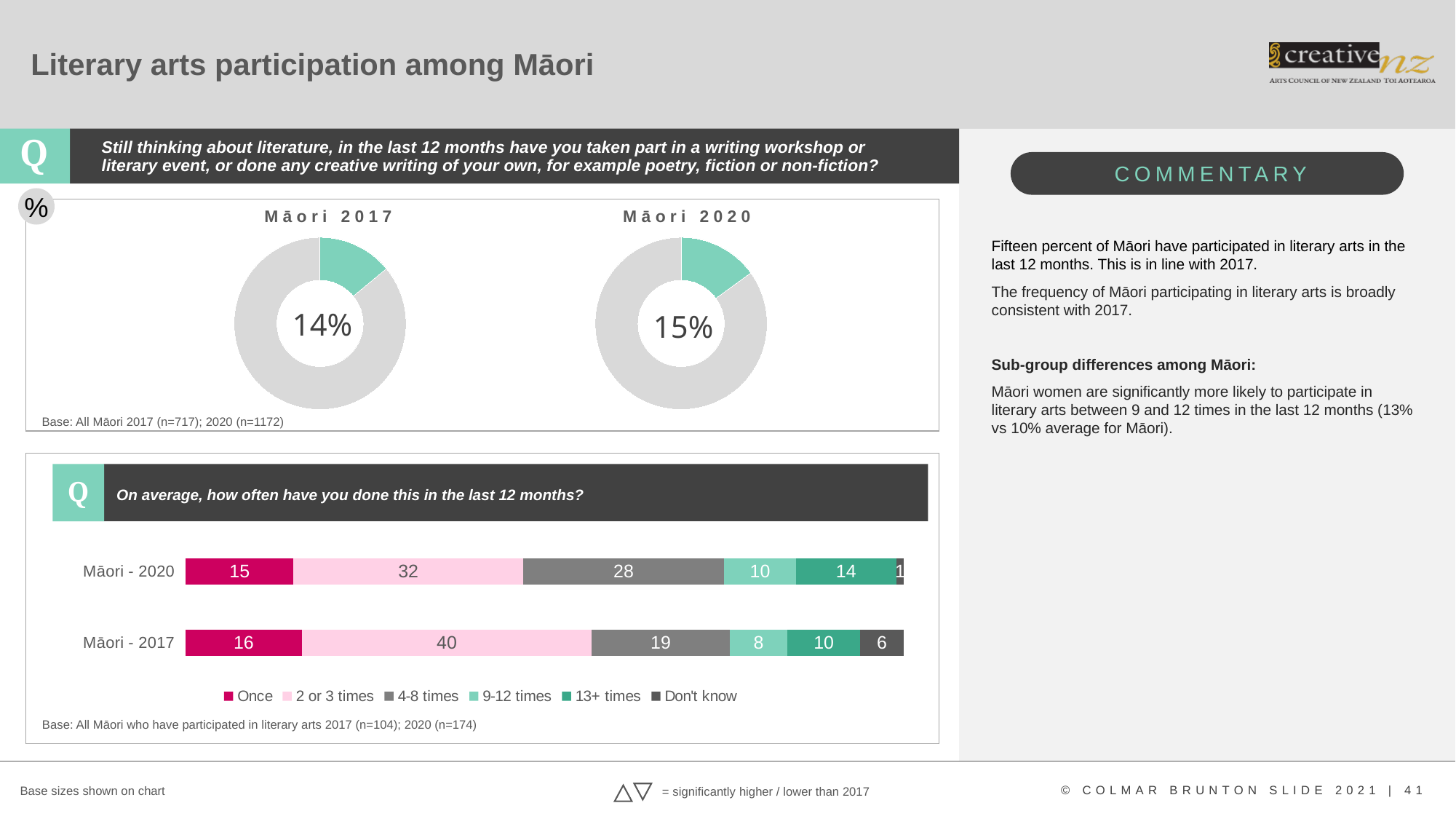
In the stacked bar chart on how often respondents have done this, is the '13+ times' value larger for Māori - 2020 or Māori - 2017? Māori - 2020 In the stacked bar chart on how often respondents have done this, what is the value for '2 or 3 times' in the Māori - 2020 bar? 32 In the Māori 2017 donut chart, what percentage is shown in the centre? 14% What type of chart is used to show how often respondents have done this in the last 12 months? Stacked bar chart In the stacked bar chart on how often respondents have done this, what is the difference between the '2 or 3 times' values for Māori - 2017 and Māori - 2020? 8 Which donut chart shows the higher participation percentage, Māori 2017 or Māori 2020? Māori 2020 In the stacked bar chart on how often respondents have done this, what is the value for '4-8 times' in the Māori - 2017 bar? 19 In the stacked bar chart on how often respondents have done this, which segment is the smallest in the Māori - 2020 bar? Don't know In the Māori 2020 donut chart, what percentage is shown in the centre? 15% In the stacked bar chart on how often respondents have done this, which segment is the largest in the Māori - 2017 bar? 2 or 3 times How many series does the legend of the stacked bar chart list? 6 In the stacked bar chart on how often respondents have done this, what is the value for 'Don't know' in the Māori - 2017 bar? 6